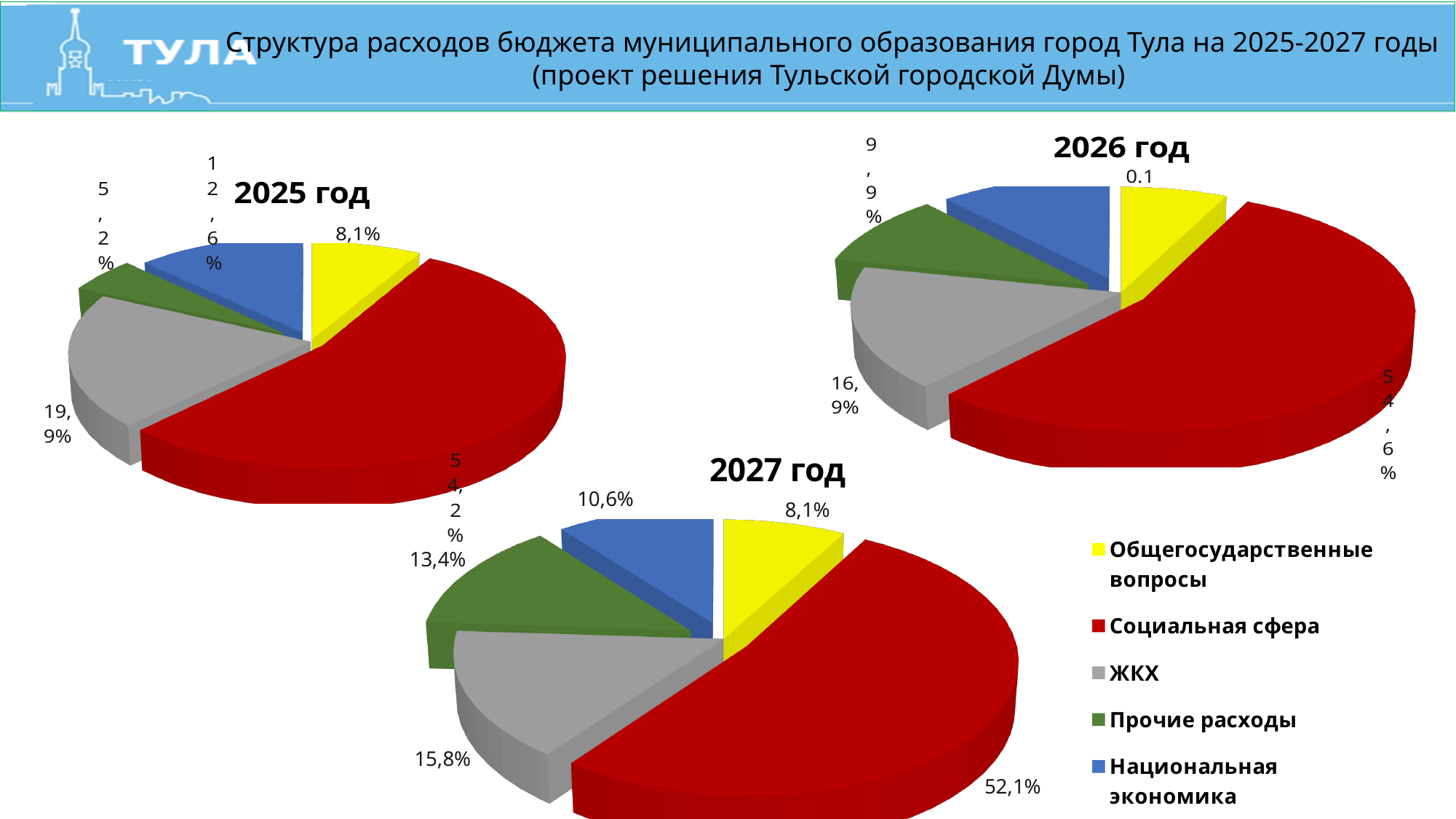
In the 2025 год chart, what share is shown for Социальная сфера? 54,2% In the 2027 год chart, which is larger: Прочие расходы or Национальная экономика? Прочие расходы What kind of chart is used for the 2025 год chart? pie chart How many categories does the legend list? 5 In the 2027 год chart, which category has the largest slice? Социальная сфера In the 2025 год chart, which category has the smallest slice? Прочие расходы In the 2027 год chart, what is the difference between the shares of Социальная сфера and ЖКХ? 36,3% In the 2026 год chart, what share is shown for ЖКХ? 16,9% In the 2025 год chart, what is the difference between the shares of ЖКХ and Национальная экономика? 7,3% In the 2027 год chart, what share is shown for Прочие расходы? 13,4% In the 2027 год chart, what share is shown for Социальная сфера? 52,1% In the 2025 год chart, what share is shown for ЖКХ? 19,9%